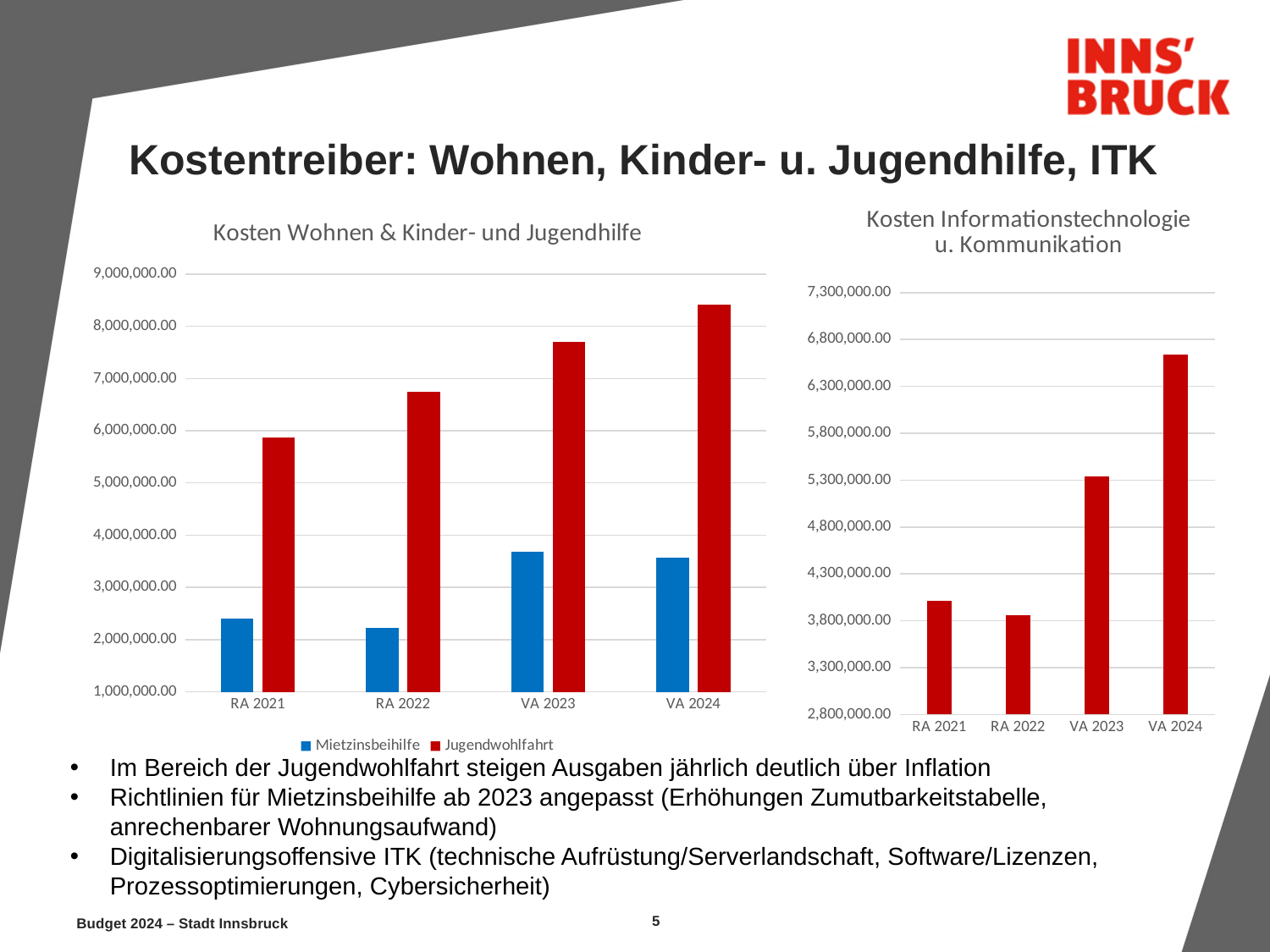
In the left chart "Kosten Wohnen & Kinder- und Jugendhilfe", which colour represents the Mietzinsbeihilfe series? blue In the left chart "Kosten Wohnen & Kinder- und Jugendhilfe", do the Jugendwohlfahrt values rise or fall from RA 2021 to VA 2024? rise In the right chart "Kosten Informationstechnologie u. Kommunikation", which category has the lowest value? RA 2022 In the left chart "Kosten Wohnen & Kinder- und Jugendhilfe", is the Jugendwohlfahrt value for VA 2024 greater or less than 8,000,000.00? greater How many series does the legend of the left chart "Kosten Wohnen & Kinder- und Jugendhilfe" list? 2 In the left chart "Kosten Wohnen & Kinder- und Jugendhilfe", is the Jugendwohlfahrt value for RA 2021 greater or less than 6,000,000.00? less What type of chart is the left chart titled "Kosten Wohnen & Kinder- und Jugendhilfe"? bar chart In the left chart "Kosten Wohnen & Kinder- und Jugendhilfe", which category has the lowest Mietzinsbeihilfe value? RA 2022 In the right chart "Kosten Informationstechnologie u. Kommunikation", which category has the highest value? VA 2024 In the right chart "Kosten Informationstechnologie u. Kommunikation", is the value for VA 2023 greater or less than 4,800,000.00? greater In the left chart "Kosten Wohnen & Kinder- und Jugendhilfe", which category has the highest Jugendwohlfahrt value? VA 2024 How many categories are shown on the x axis of the right chart "Kosten Informationstechnologie u. Kommunikation"? 4